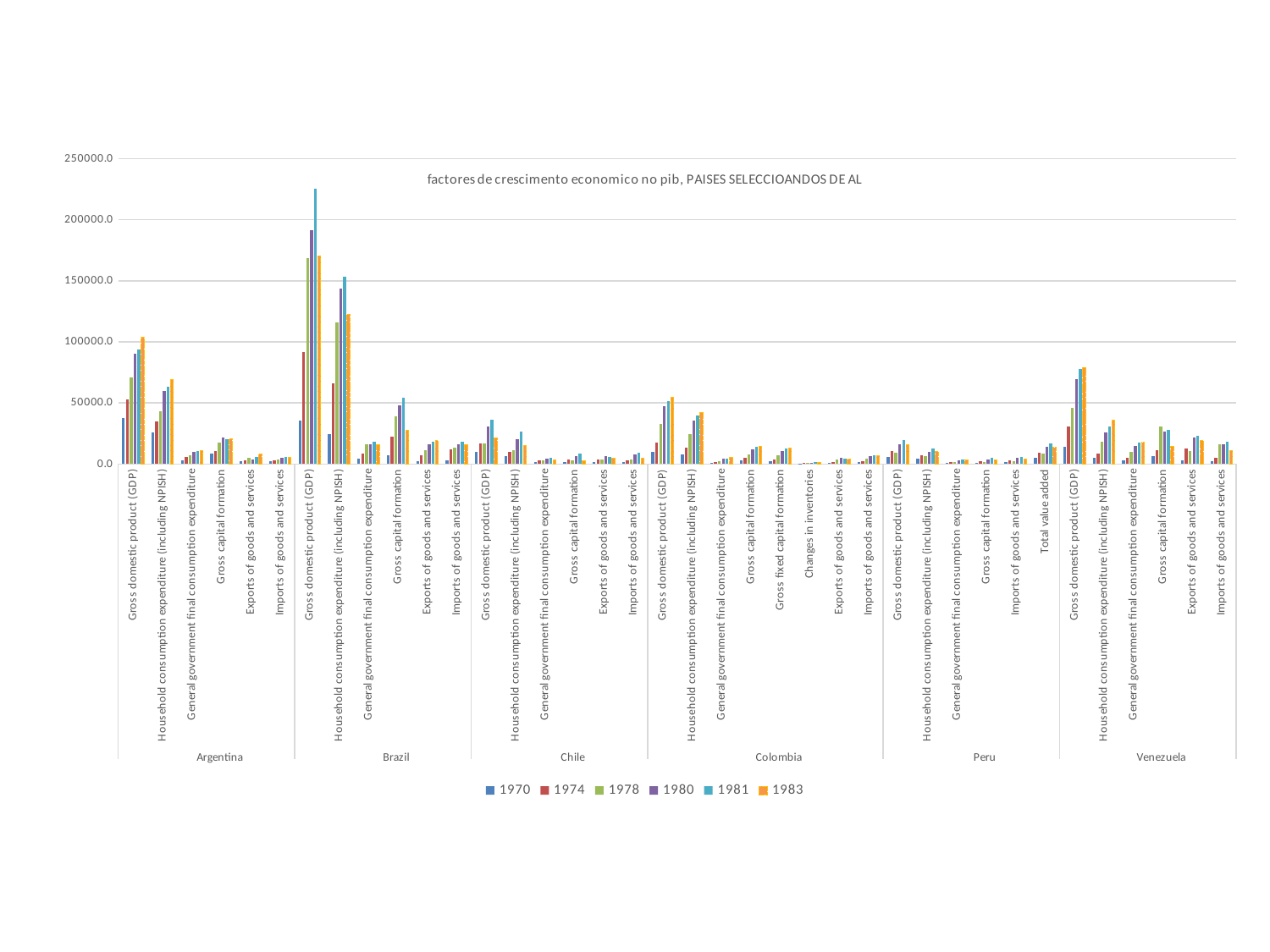
Which years are listed in the chart legend? 1970, 1974, 1978, 1980, 1981, 1983 Is the 1981 value for Chile's Gross domestic product (GDP) greater or less than 50000.0? less How many indicator categories are shown for Colombia? 8 Is the 1983 value for Venezuela's Gross domestic product (GDP) greater or less than 50000.0? greater How many series does the legend list? 6 Which country and indicator has the tallest bar in the chart? Brazil, Gross domestic product (GDP) How many countries are shown along the x axis of the chart? 6 Is the 1981 value for Brazil's Gross domestic product (GDP) greater or less than 200000.0? greater Which is larger in 1981: Brazil's Gross domestic product (GDP) or Argentina's Gross domestic product (GDP)? Brazil's Gross domestic product (GDP) Do the Gross domestic product (GDP) bars for Argentina rise or fall from 1970 to 1983? rise What kind of chart is shown on the slide? bar chart